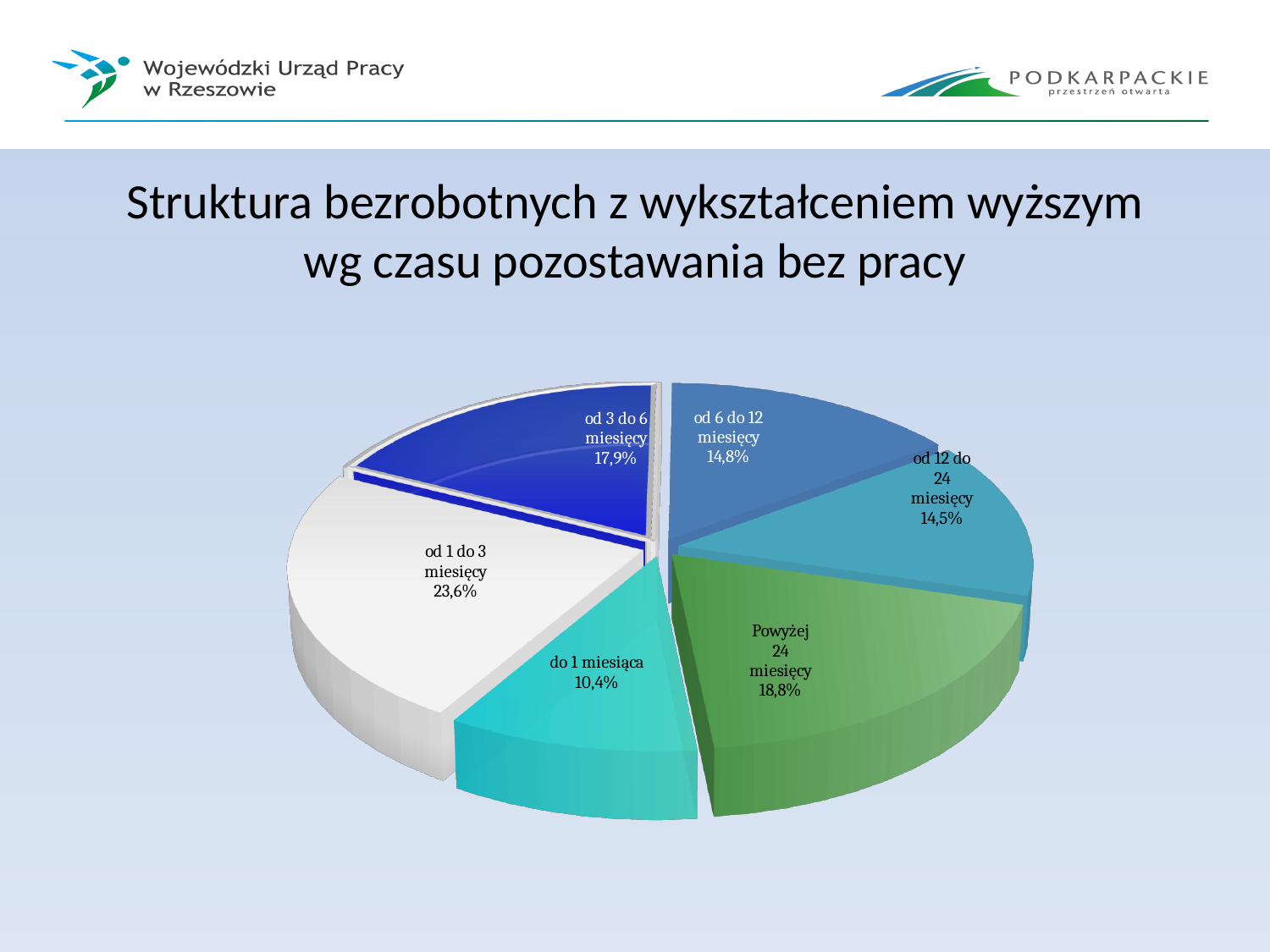
How many slices does the pie chart have? 6 Which category has the largest share of the pie? od 1 do 3 miesięcy Which is larger, the share for "Powyżej 24 miesięcy" or for "od 6 do 12 miesięcy"? Powyżej 24 miesięcy What is the value shown for "od 3 do 6 miesięcy"? 17,9% What is the difference between the shares for "od 1 do 3 miesięcy" and "do 1 miesiąca"? 13,2 percentage points What share of the pie is labelled "od 1 do 3 miesięcy"? 23,6% What is the value shown for "do 1 miesiąca"? 10,4% What is the title of the slide containing the chart? Struktura bezrobotnych z wykształceniem wyższym wg czasu pozostawania bez pracy Which category has the smallest share of the pie? do 1 miesiąca What is the value shown for "Powyżej 24 miesięcy"? 18,8% What is the value shown for "od 12 do 24 miesięcy"? 14,5% What kind of chart is shown on the slide? pie chart